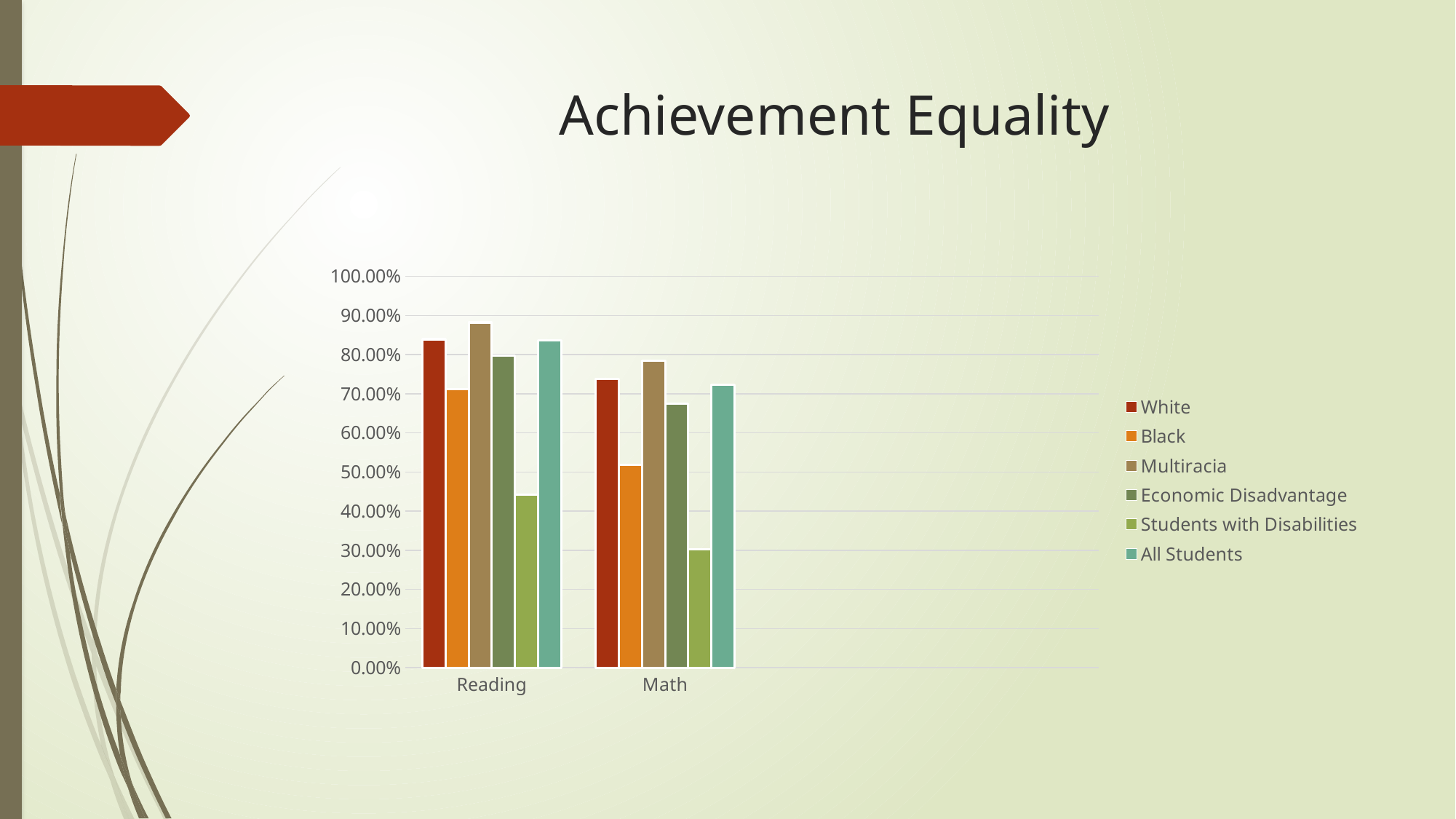
Which is larger, the Black value for Reading or the Black value for Math? Reading What is the title of the slide containing the chart? Achievement Equality Is the value for Economic Disadvantage in Reading greater or less than 70.00%? greater Which series has the lowest value for Reading? Students with Disabilities What kind of chart is shown on the slide? bar chart Is the value for Black in Math greater or less than 60.00%? less Which series has the lowest value for Math? Students with Disabilities How many series does the legend list? 6 Is the value for Students with Disabilities in Reading greater or less than 50.00%? less Which series has the highest value for Reading? Multiracia How many categories are shown on the x axis? 2 Do the values for Students with Disabilities rise or fall from Reading to Math? fall